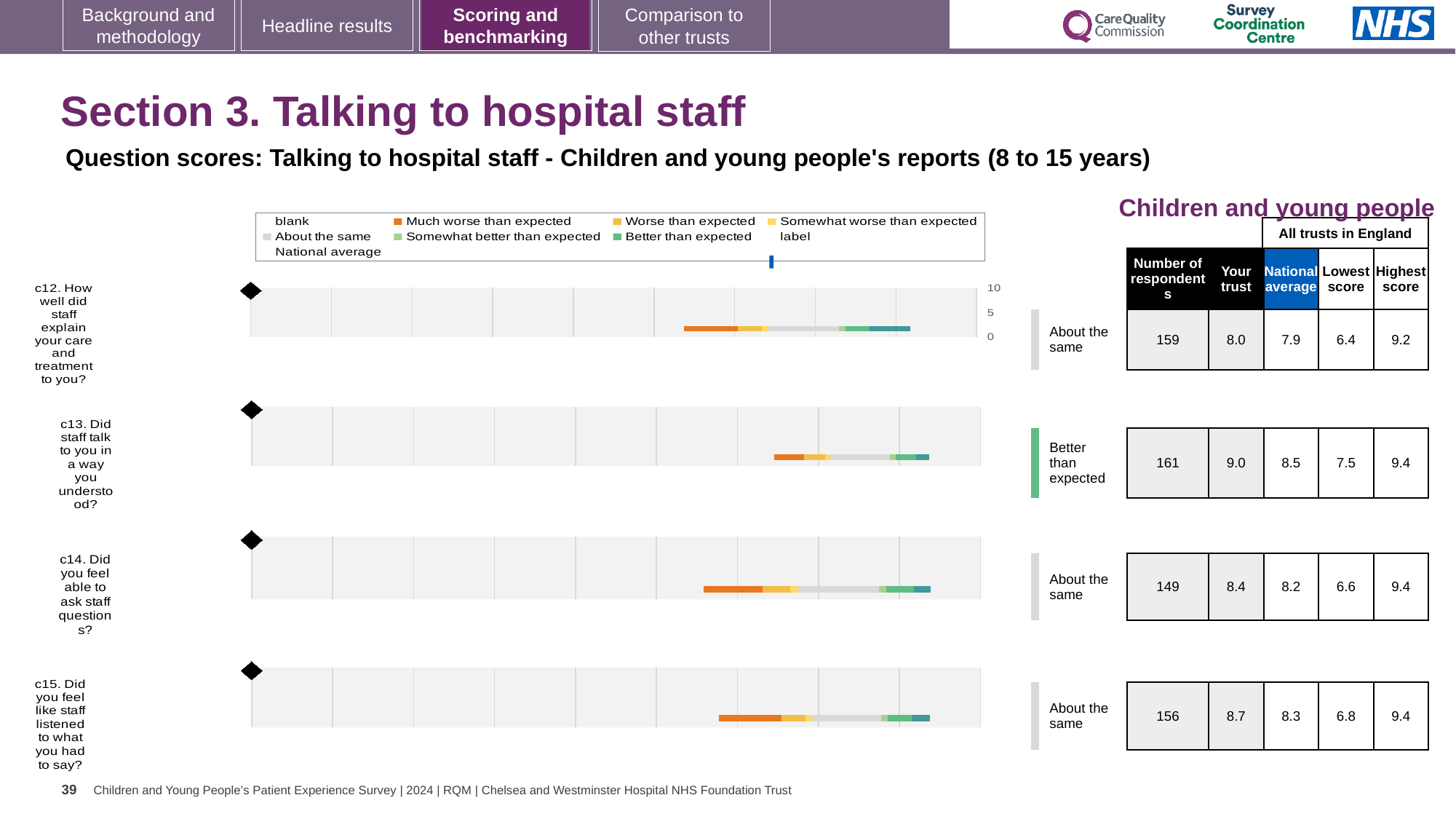
How many entries does the legend above the charts list? 9 What kind of chart is used to show the benchmarking for each question on this slide? Bar chart What is the difference between the 'Your trust' score and the national average for c13? 0.5 Which question has the highest 'Your trust' score on this slide? c13 What is the 'Your trust' score for c13 (Did staff talk to you in a way you understood?)? 9.0 What is the national average score for c15 (Did you feel like staff listened to what you had to say?)? 8.3 What is the lowest score across all trusts in England for c12? 6.4 Which question has the lowest 'Your trust' score on this slide? c12 Which is larger for c12: the 'Your trust' score or the national average? Your trust How many respondents answered c14 (Did you feel able to ask staff questions?)? 149 What benchmark category is shown for c13 (Did staff talk to you in a way you understood?)? Better than expected How many questions (c12 to c15) are plotted as separate bars on this slide? 4